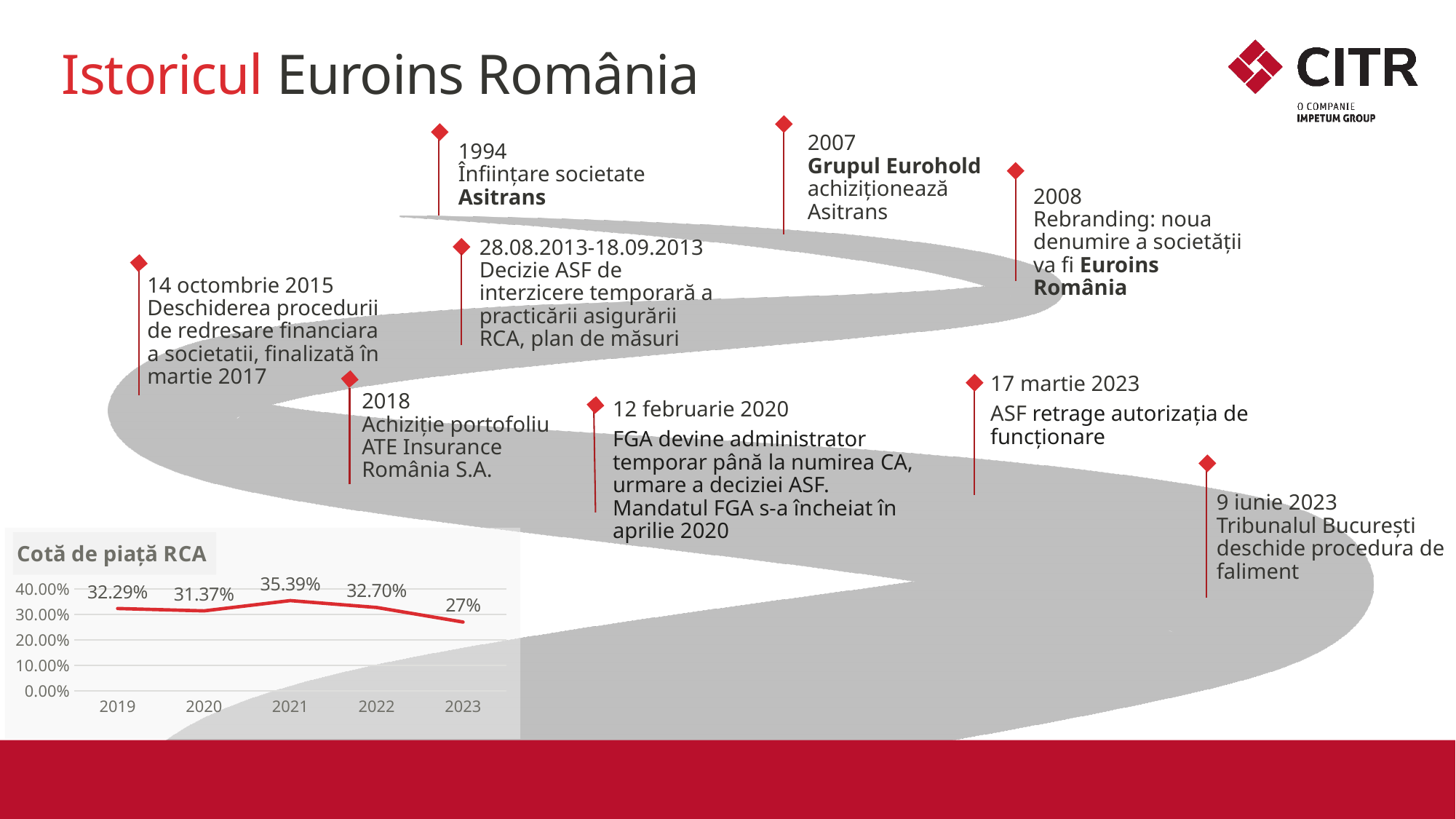
What is the RCA market share value for 2023 in the "Cotă de piață RCA" chart? 27% What is the RCA market share value for 2019 in the "Cotă de piață RCA" chart? 32.29% What kind of chart is the "Cotă de piață RCA" chart? line chart In the "Cotă de piață RCA" chart, does the value rise or fall from 2021 to 2023? fall Which year has the highest RCA market share in the "Cotă de piață RCA" chart? 2021 Which year has the lowest RCA market share in the "Cotă de piață RCA" chart? 2023 In the "Cotă de piață RCA" chart, is the value for 2023 greater or less than 30.00%? less In the "Cotă de piață RCA" chart, is the value for 2020 or 2022 larger? 2022 How many years are plotted in the "Cotă de piață RCA" chart? 5 What is the title of the chart on the slide? Cotă de piață RCA What is the difference between the 2021 and 2022 values in the "Cotă de piață RCA" chart? 2.69% What is the RCA market share value for 2021 in the "Cotă de piață RCA" chart? 35.39%